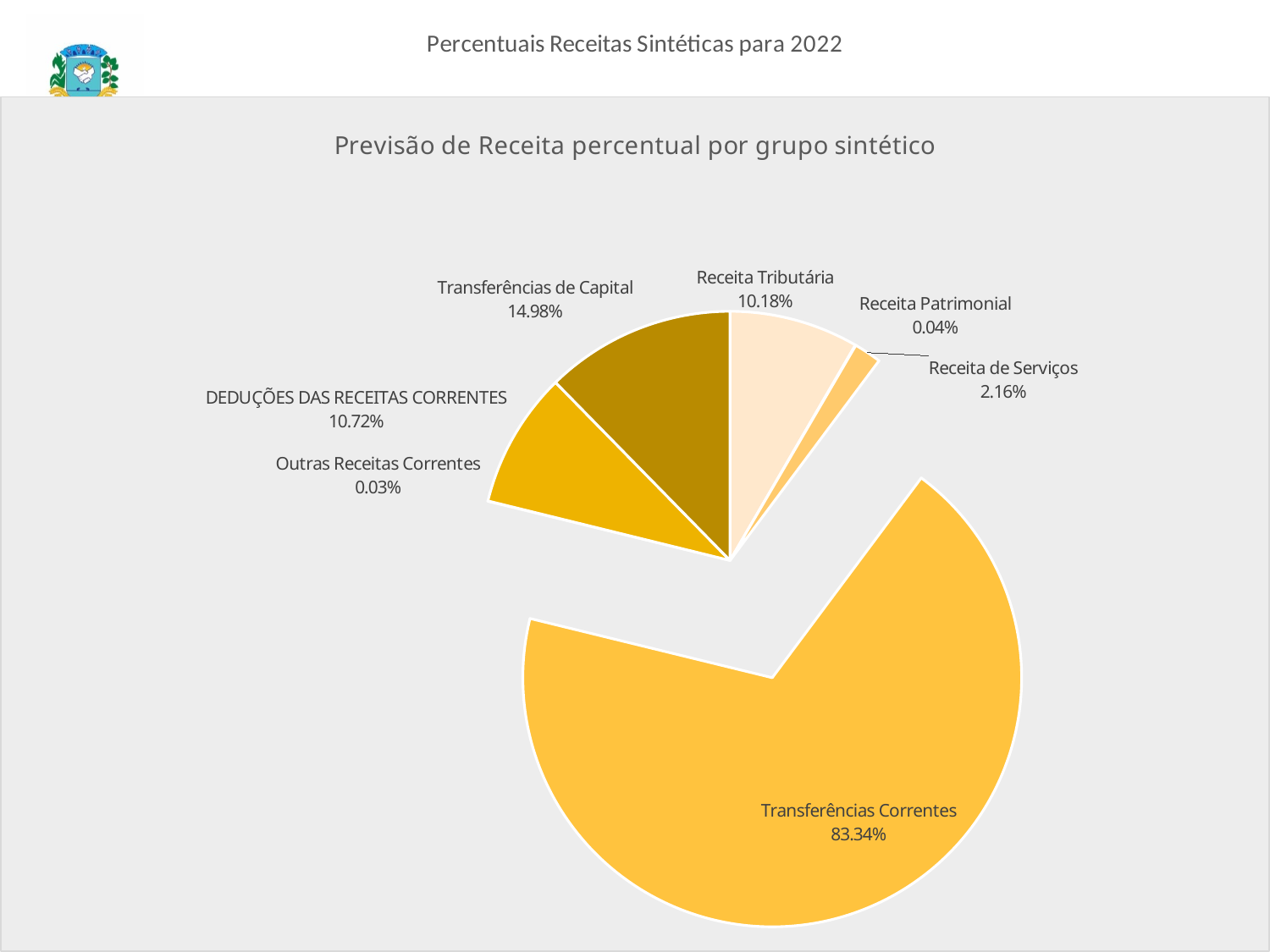
What is the title of the chart? Previsão de Receita percentual por grupo sintético How many categories are shown in the pie chart? 7 What percentage is shown for Receita Patrimonial? 0.04% What percentage is shown for Transferências de Capital? 14.98% What kind of chart is shown on the slide? Pie chart What percentage is shown for Receita Tributária? 10.18% What percentage is shown for Transferências Correntes? 83.34% What is the difference between the percentages for Transferências Correntes and Transferências de Capital? 68.36% What percentage is shown for DEDUÇÕES DAS RECEITAS CORRENTES? 10.72% What percentage is shown for Receita de Serviços? 2.16% Which category has the largest slice of the pie? Transferências Correntes Which is larger, Transferências de Capital or Receita Tributária? Transferências de Capital